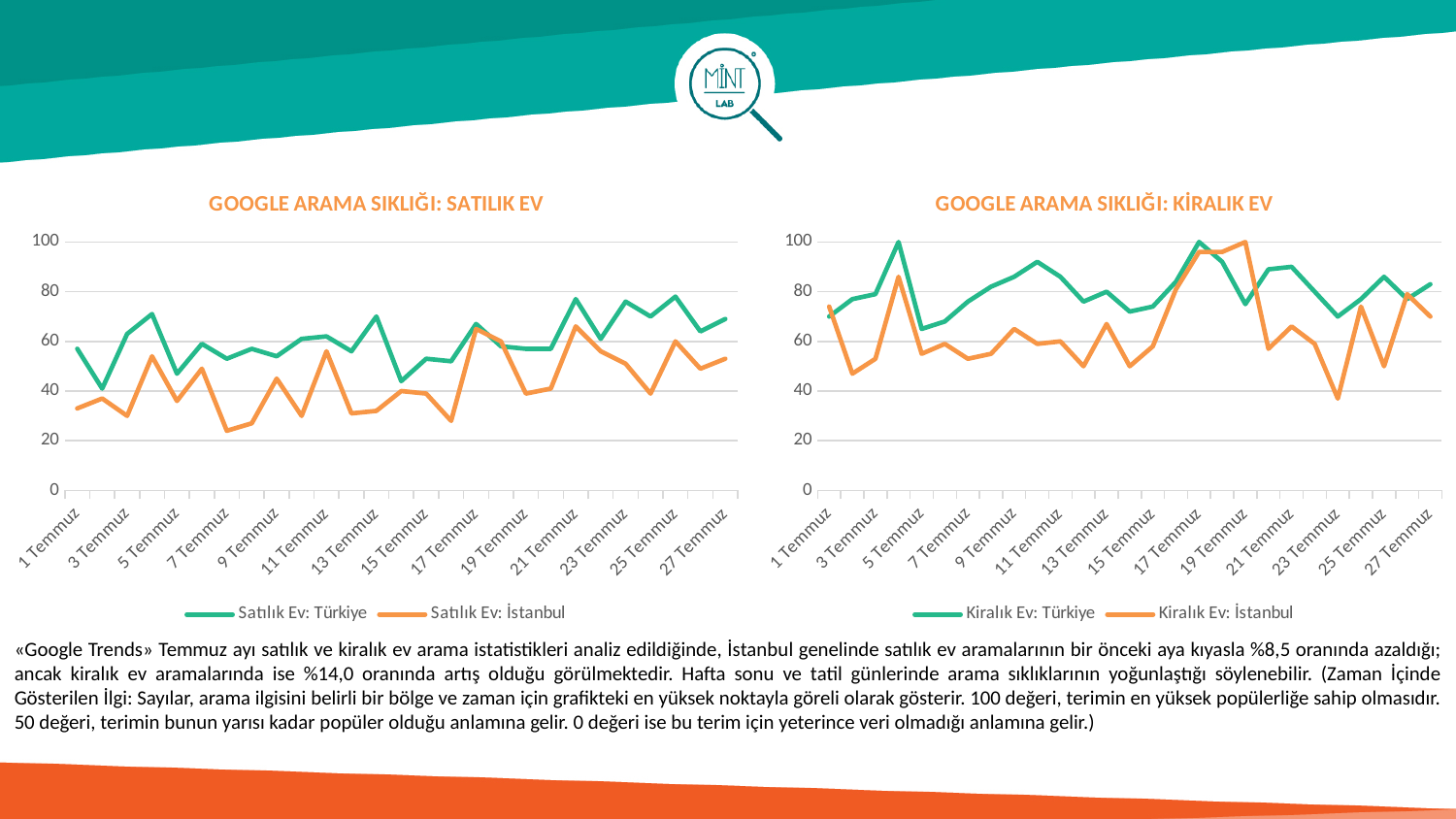
In the 'GOOGLE ARAMA SIKLIĞI: KİRALIK EV' chart, what is the highest value reached by the Kiralık Ev: Türkiye line? 100 In the 'GOOGLE ARAMA SIKLIĞI: KİRALIK EV' chart, which series has the higher value on 5 Temmuz, Kiralık Ev: Türkiye or Kiralık Ev: İstanbul? Kiralık Ev: Türkiye In the 'GOOGLE ARAMA SIKLIĞI: KİRALIK EV' chart, is the value for Kiralık Ev: Türkiye on 5 Temmuz greater or less than 80? less In the 'GOOGLE ARAMA SIKLIĞI: SATILIK EV' chart, which series has the higher value on 1 Temmuz, Satılık Ev: Türkiye or Satılık Ev: İstanbul? Satılık Ev: Türkiye In the 'GOOGLE ARAMA SIKLIĞI: KİRALIK EV' chart, which colour is used for the Kiralık Ev: İstanbul line? Orange What kind of chart is the 'GOOGLE ARAMA SIKLIĞI: SATILIK EV' chart? Line chart In the 'GOOGLE ARAMA SIKLIĞI: KİRALIK EV' chart, is the value for Kiralık Ev: İstanbul on 3 Temmuz greater or less than 60? less How many date labels are shown on the x axis of the 'GOOGLE ARAMA SIKLIĞI: SATILIK EV' chart? 14 In the 'GOOGLE ARAMA SIKLIĞI: SATILIK EV' chart, is the value for Satılık Ev: İstanbul on 1 Temmuz greater or less than 40? less How many series does the legend of the 'GOOGLE ARAMA SIKLIĞI: KİRALIK EV' chart list? 2 In the 'GOOGLE ARAMA SIKLIĞI: SATILIK EV' chart, what are the two series named in the legend? Satılık Ev: Türkiye and Satılık Ev: İstanbul